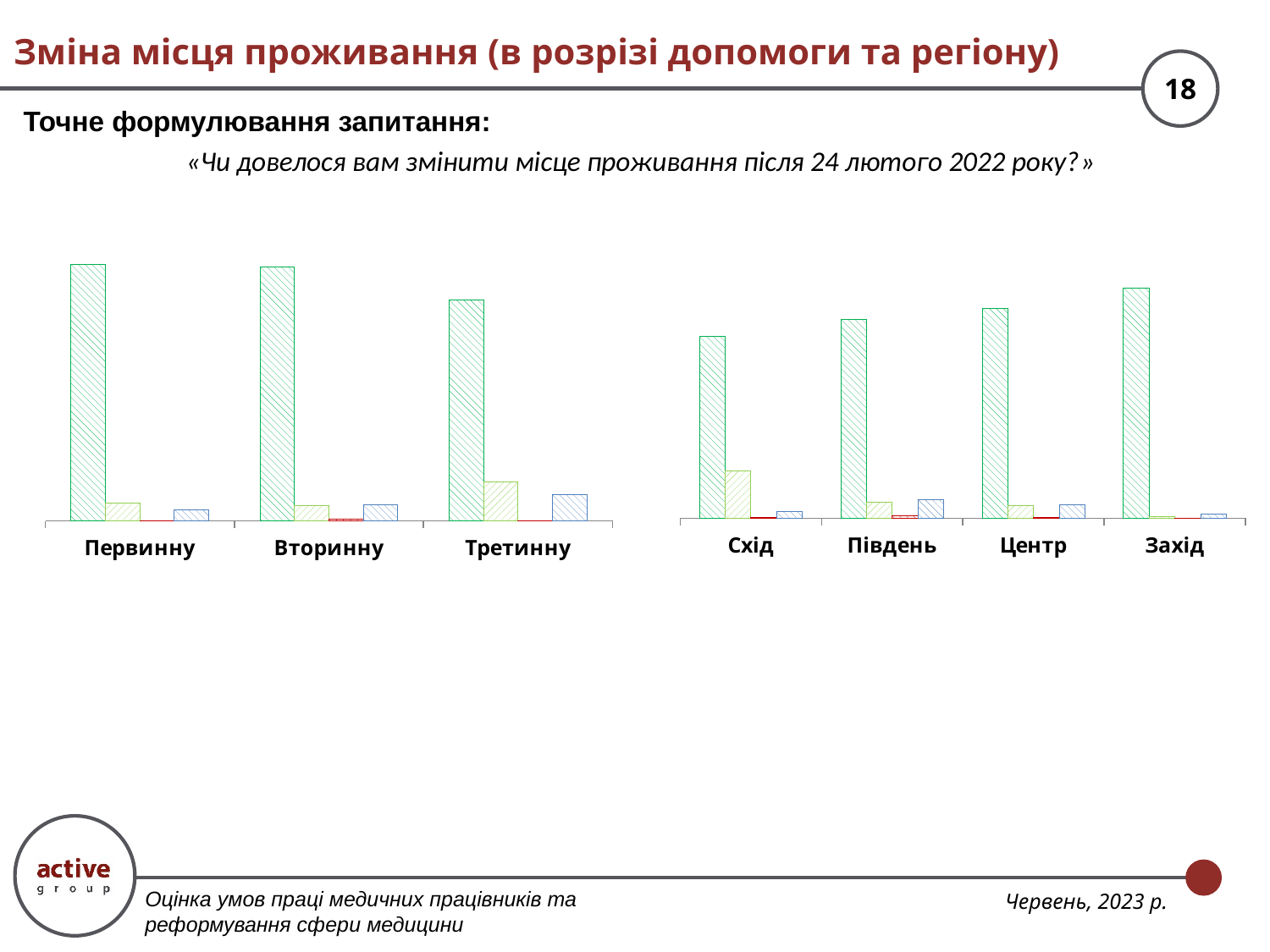
How many categories are shown on the x axis of the left chart? 3 In the left chart, which category has the shortest first (green hatched) bar? Третинну In the right chart, do the first (green hatched) bars rise or fall from Схід to Захід? rise In the right chart, is the first (green hatched) bar taller for Схід or for Захід? Захід What kind of chart is the chart on the left of the slide (with categories Первинну, Вторинну, Третинну)? bar chart In the left chart, which category has the tallest second (light green) bar? Третинну What kind of chart is the chart on the right of the slide (with categories Схід, Південь, Центр, Захід)? bar chart How many categories are shown on the x axis of the right chart? 4 What is the name of the region listed last on the x axis of the right chart? Захід In the left chart, is the first (green hatched) bar taller for Первинну or for Третинну? Первинну In the right chart, which region has the shortest first (green hatched) bar? Схід In the right chart, which region has the tallest first (green hatched) bar? Захід